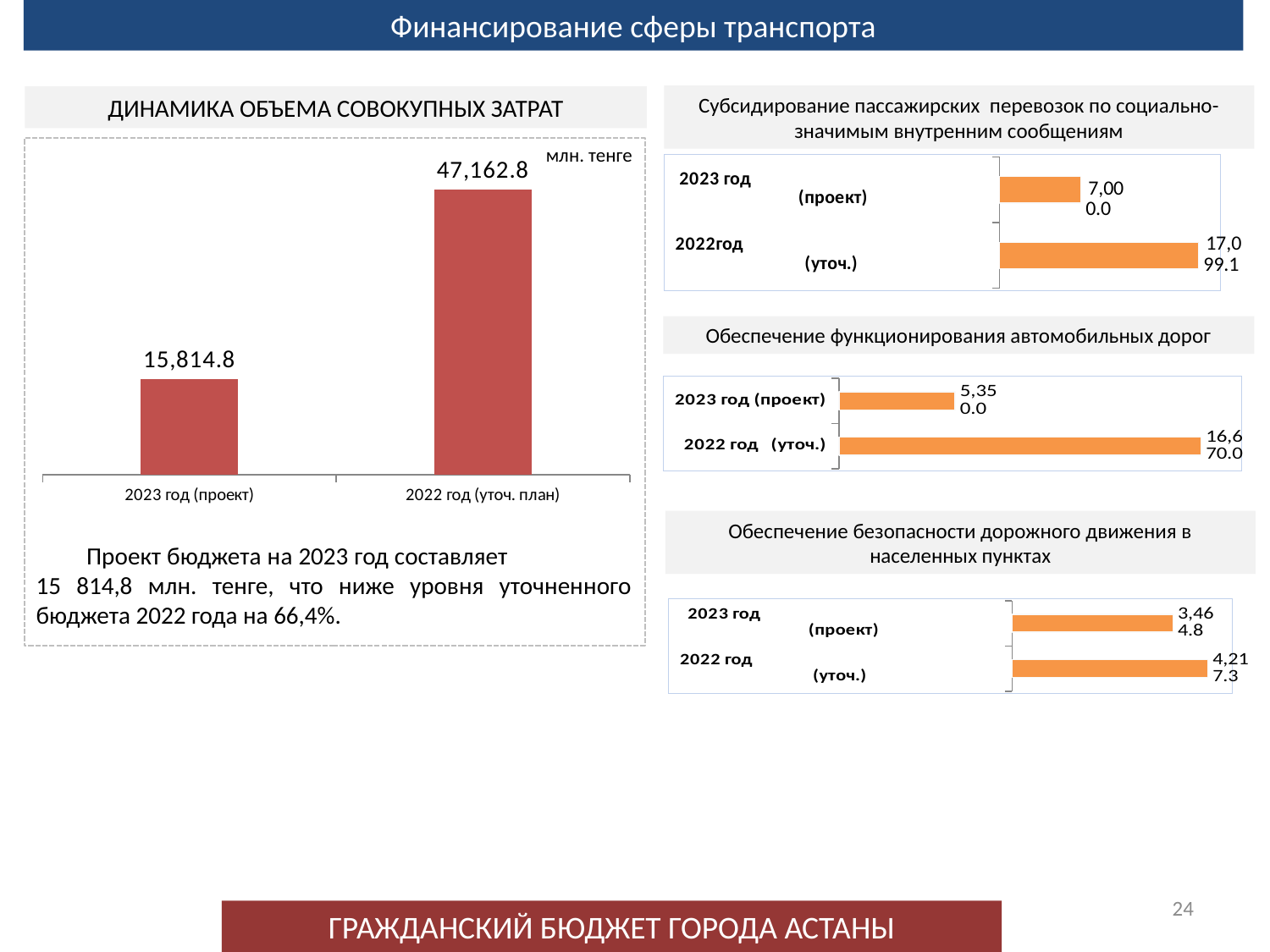
In the chart 'Обеспечение безопасности дорожного движения в населенных пунктах', which category has the larger value: 2023 год (проект) or 2022 год (уточ.)? 2022 год (уточ.) In the chart 'Субсидирование пассажирских перевозок по социально-значимым внутренним сообщениям', which category has the larger value: 2023 год (проект) or 2022год (уточ.)? 2022год (уточ.) In the chart 'ДИНАМИКА ОБЪЕМА СОВОКУПНЫХ ЗАТРАТ', which category has the highest value? 2022 год (уточ. план) What type of chart is 'Обеспечение функционирования автомобильных дорог'? bar chart In the chart 'Обеспечение функционирования автомобильных дорог', which category has the lowest value? 2023 год (проект) In the chart 'ДИНАМИКА ОБЪЕМА СОВОКУПНЫХ ЗАТРАТ', how many bars are plotted? 2 What type of chart is 'ДИНАМИКА ОБЪЕМА СОВОКУПНЫХ ЗАТРАТ'? bar chart What unit is shown on the chart 'ДИНАМИКА ОБЪЕМА СОВОКУПНЫХ ЗАТРАТ'? млн. тенге How many charts are shown on the slide in total? 4 In the chart 'ДИНАМИКА ОБЪЕМА СОВОКУПНЫХ ЗАТРАТ', what is the value for 2023 год (проект)? 15,814.8 In the chart 'ДИНАМИКА ОБЪЕМА СОВОКУПНЫХ ЗАТРАТ', what is the value for 2022 год (уточ. план)? 47,162.8 In the chart 'ДИНАМИКА ОБЪЕМА СОВОКУПНЫХ ЗАТРАТ', what is the difference between the 2022 год (уточ. план) value and the 2023 год (проект) value? 31,348.0